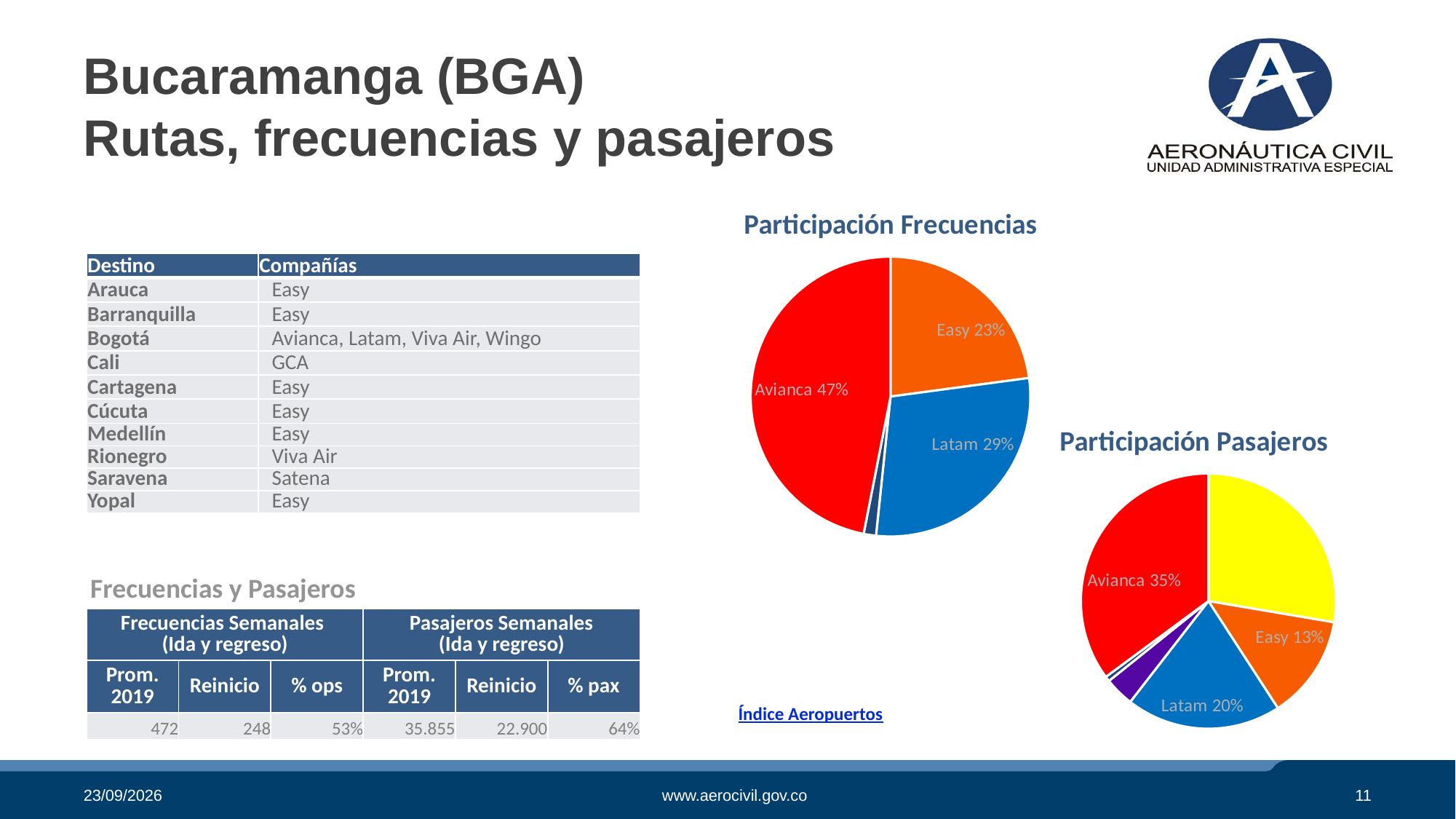
In the Participación Pasajeros chart, what share does Avianca have? 35% What type of chart is the Participación Pasajeros chart? Pie chart In the Participación Pasajeros chart, what share does Easy have? 13% In the Participación Frecuencias chart, which labelled airline has the largest share? Avianca In the Participación Frecuencias chart, what share does Avianca have? 47% In the Participación Pasajeros chart, which is larger, Latam's share or Easy's share? Latam In the Participación Frecuencias chart, what share does Easy have? 23% In the Participación Pasajeros chart, what share does Latam have? 20% What colour is the Avianca slice in the Participación Frecuencias chart? Red In the Participación Pasajeros chart, how many percentage points larger is Avianca's share than Easy's? 22% In the Participación Frecuencias chart, what share does Latam have? 29% In the Participación Frecuencias chart, how many percentage points larger is Avianca's share than Latam's? 18%